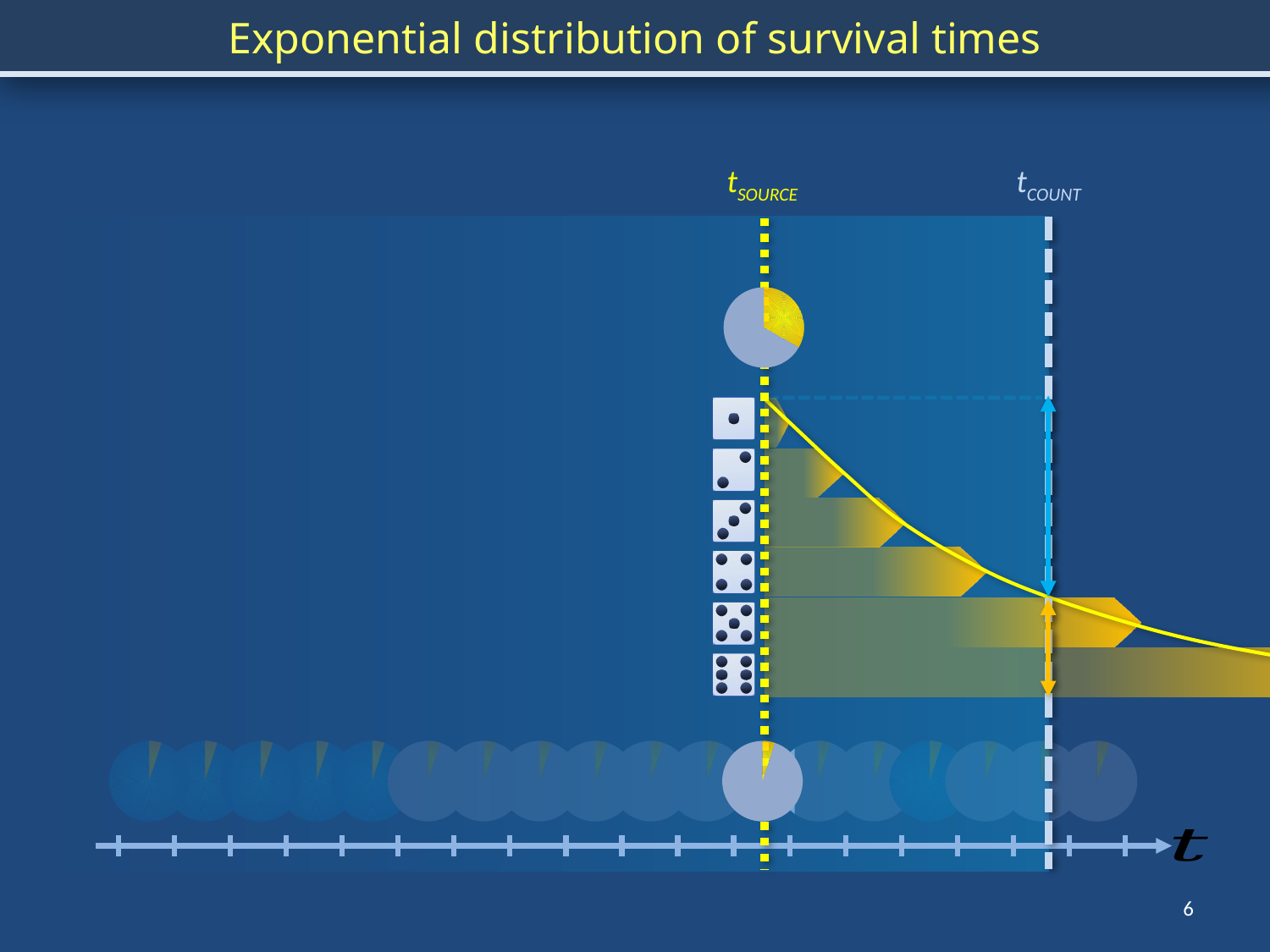
How many dice are stacked along the t_SOURCE line? 6 What is the title of the slide's chart? Exponential distribution of survival times What is the label on the horizontal axis of the chart? t Does the yellow curve rise or fall as t increases to the right of t_SOURCE? fall Which of the two labelled vertical lines is further to the right along the t axis, t_SOURCE or t_COUNT? t_COUNT Is the yellow curve higher at t_SOURCE or at t_COUNT? t_SOURCE